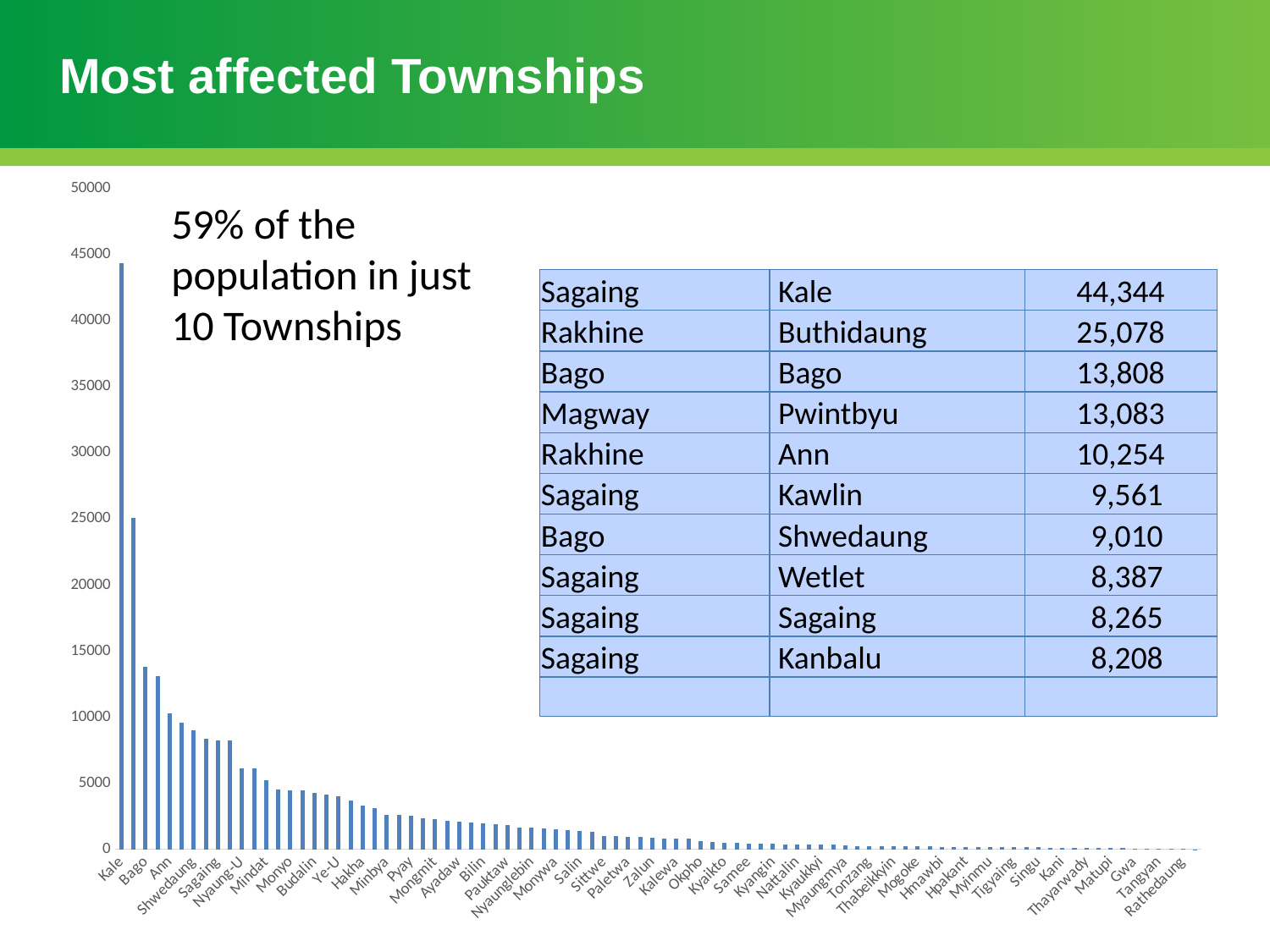
What is the difference between the values for Kale and Buthidaung? 19,266 What is the highest value shown on the chart's vertical axis? 50000 Which is larger, the value for Kale or the value for Buthidaung? Kale What is the value for Kanbalu? 8,208 What is the value for Buthidaung? 25,078 Is the value for Kale greater or less than 40000? greater Which township has the highest value in the chart? Kale Is the value for Bago greater or less than 15000? less What kind of chart is shown on the slide? bar chart What is the value for Kale? 44,344 What is the title of the slide containing the chart? Most affected Townships Do the bar values rise or fall from left to right along the x axis? fall